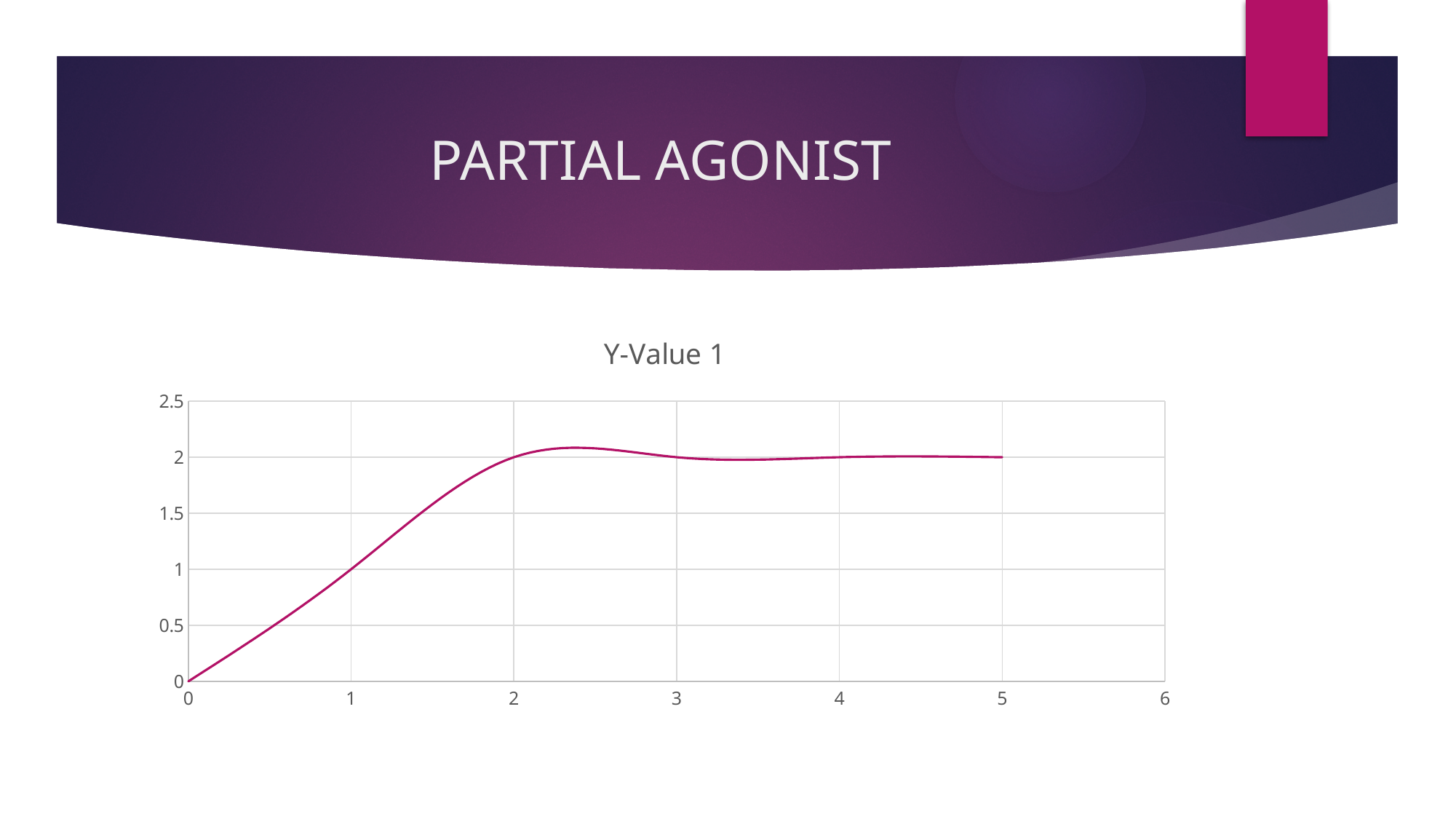
At what x value does the plotted line end? 5 Does the line rise or fall between x = 0 and x = 2? rises What is the title of the chart? Y-Value 1 What is the highest value labelled on the y axis? 2.5 What is the value of the line at x = 0? 0 What is the value of the line at x = 1? 1 Is the value of the line at x = 4 greater or less than 2.5? less Is the value of the line at x = 3 greater or less than 1.5? greater Is the value of the line at x = 1 greater or less than 1.5? less Which is larger, the value of the line at x = 1 or at x = 4? x = 4 What kind of chart is shown on the slide? line chart